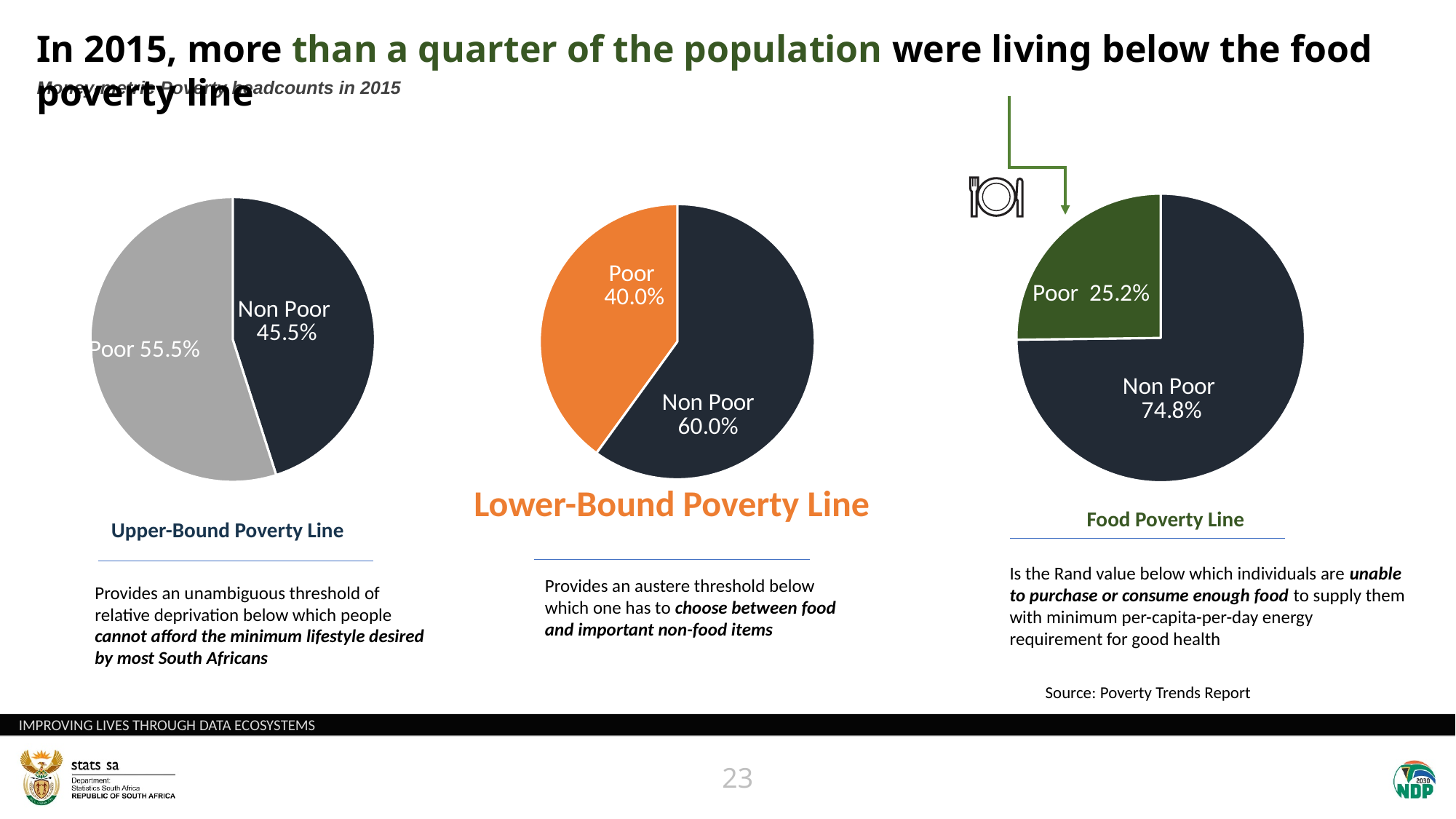
In the Food Poverty Line pie chart, which slice is the largest? Non Poor What colour is the Poor slice in the Lower-Bound Poverty Line pie chart? Orange In the Food Poverty Line pie chart, what share of the population is Non Poor? 74.8% In the Lower-Bound Poverty Line pie chart, what is the difference between the Non Poor and Poor shares? 20.0% In the Lower-Bound Poverty Line pie chart, what share of the population is Non Poor? 60.0% How many slices does the Lower-Bound Poverty Line pie chart have? 2 What type of chart is used for the Food Poverty Line? Pie chart In the Upper-Bound Poverty Line pie chart, what share of the population is Non Poor? 45.5% In the Upper-Bound Poverty Line pie chart, what share of the population is Poor? 55.5% In the Lower-Bound Poverty Line pie chart, what share of the population is Poor? 40.0% In the Upper-Bound Poverty Line pie chart, which slice is larger, Poor or Non Poor? Poor In the Food Poverty Line pie chart, what share of the population is Poor? 25.2%